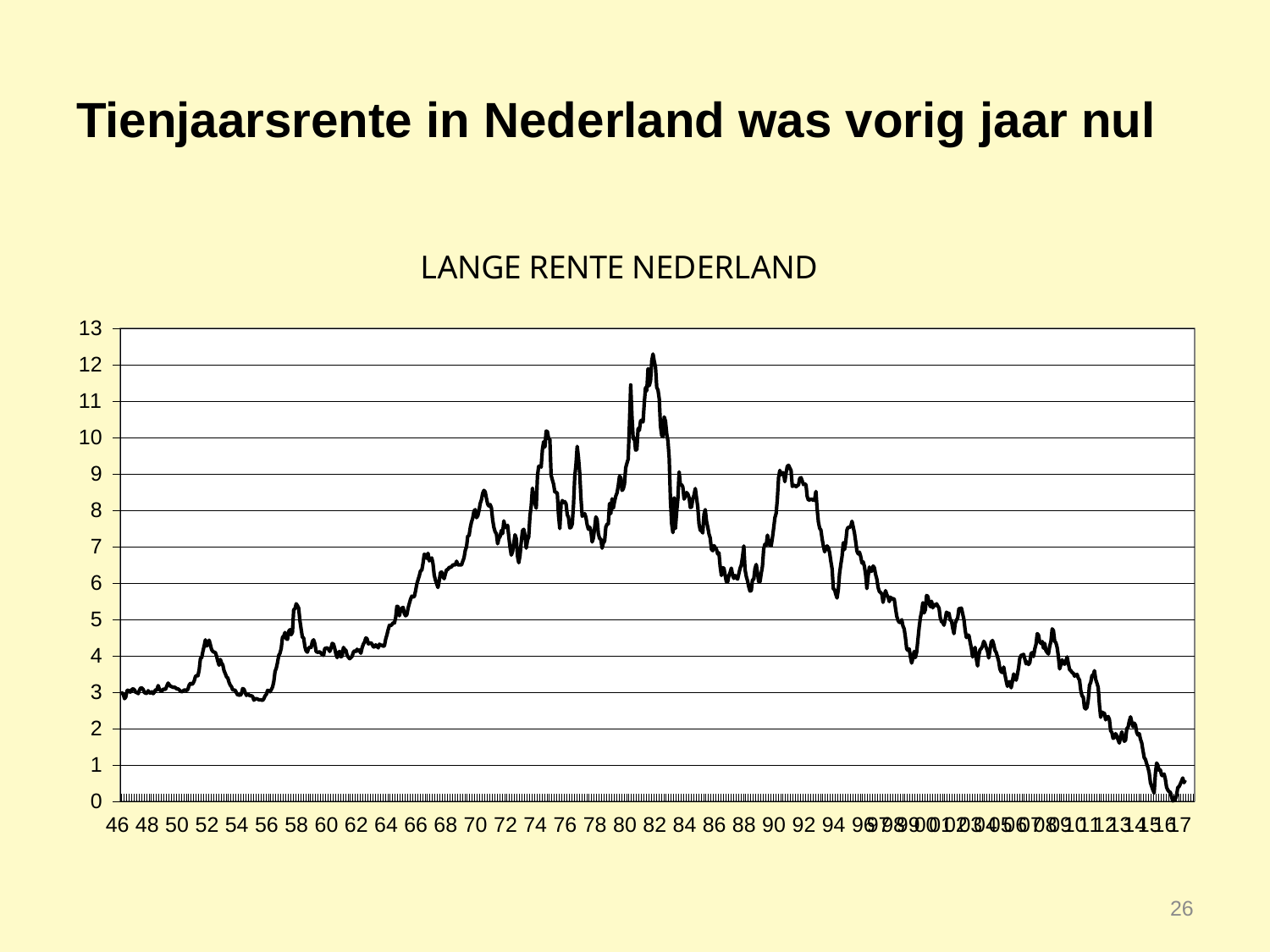
Is the value of the line at the start of the series (46) greater or less than 4? less Does the line generally rise or fall from 82 to the end of the series? fall What kind of chart is shown on the slide? line chart Which is higher, the value of the line around 70 or around 60? 70 Is the peak value of the line around 82 greater or less than 11? greater What is the highest value shown on the y axis? 13 Around which year label on the x axis does the line reach its highest value? 82 Does the line generally rise or fall from 46 to 82? rise Is the lowest value reached by the line near the end of the series greater or less than 1? less How many lines are plotted on the chart? 1 What is the title of the chart? LANGE RENTE NEDERLAND